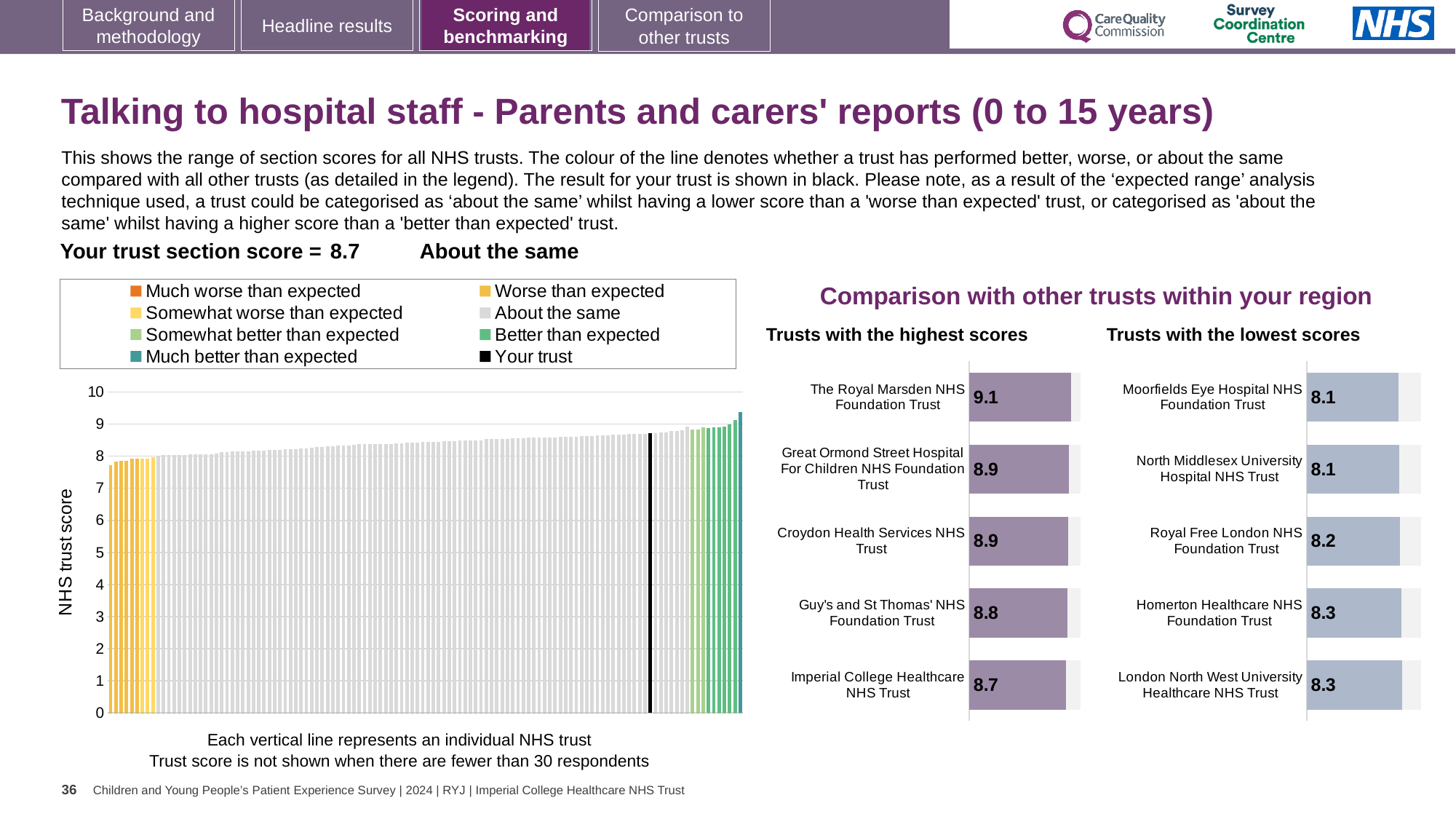
In the 'Trusts with the highest scores' chart, what is the difference between the scores of The Royal Marsden NHS Foundation Trust and Imperial College Healthcare NHS Trust? 0.4 In the 'Trusts with the highest scores' chart, what is the score for Imperial College Healthcare NHS Trust? 8.7 In the 'Trusts with the lowest scores' chart, what is the difference between the scores of Homerton Healthcare NHS Foundation Trust and Moorfields Eye Hospital NHS Foundation Trust? 0.2 In the legend of the NHS trust score chart on the left, what colour represents 'Your trust'? Black How many trusts are listed in the 'Trusts with the highest scores' chart? 5 What kind of chart is the NHS trust score chart on the left of the slide? Bar chart In the 'Trusts with the lowest scores' chart, what is the score for Royal Free London NHS Foundation Trust? 8.2 In the 'Trusts with the highest scores' chart, which trust has the highest score? The Royal Marsden NHS Foundation Trust In the 'Trusts with the highest scores' chart, which has the higher score: Croydon Health Services NHS Trust or Guy's and St Thomas' NHS Foundation Trust? Croydon Health Services NHS Trust How many entries does the legend of the NHS trust score chart on the left list? 8 In the NHS trust score chart on the left, is the lowest trust score greater or less than 8? less In the 'Trusts with the highest scores' chart, what is the score for The Royal Marsden NHS Foundation Trust? 9.1